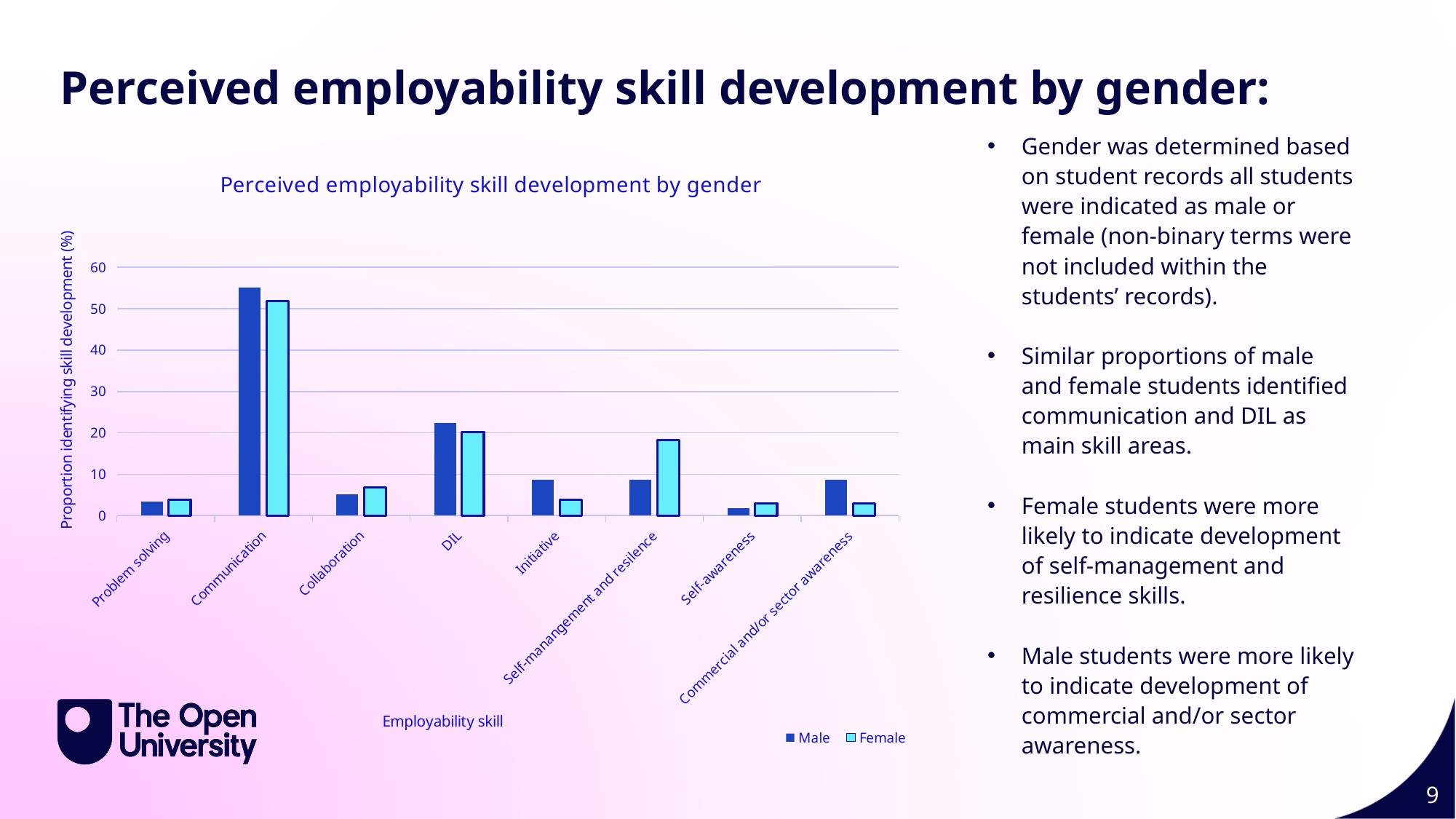
Is the Female value for Self-management and resilience greater or less than 10? greater Is the Male value for Communication greater or less than 50? greater How many employability skill categories are shown on the x axis? 8 Is the Male value for DIL greater or less than 20? greater For Commercial and/or sector awareness, which is larger: the Male value or the Female value? Male What is the label of the y axis? Proportion identifying skill development (%) What type of chart is shown on the slide? Bar chart How many series does the legend list? 2 Which employability skill has the highest value for Female students? Communication For Self-management and resilience, which is larger: the Male value or the Female value? Female Which employability skill has the highest value for Male students? Communication